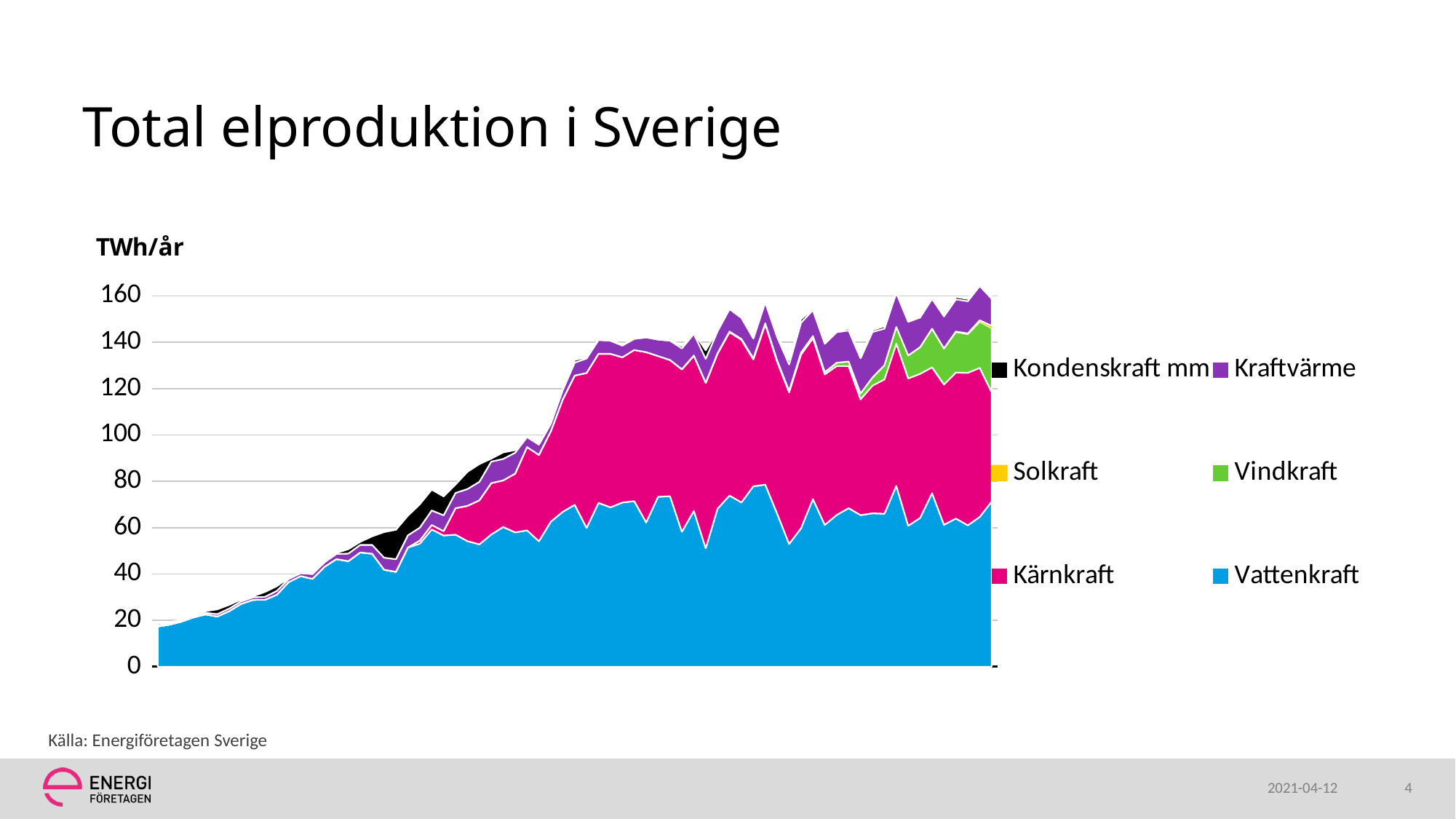
What kind of chart is shown on the slide? stacked area chart Does the total electricity production generally rise or fall from left to right? rise What is the title of the chart? Total elproduktion i Sverige How many series does the legend list? 6 Is the highest total value reached in the chart greater or less than 140? greater What is the highest value shown on the vertical axis? 160 Which series forms the bottom layer of the stacked areas? Vattenkraft Is the total value at the far left of the chart greater or less than 40? less At the far right of the chart, which is larger: the Vattenkraft area or the Kärnkraft area? Vattenkraft